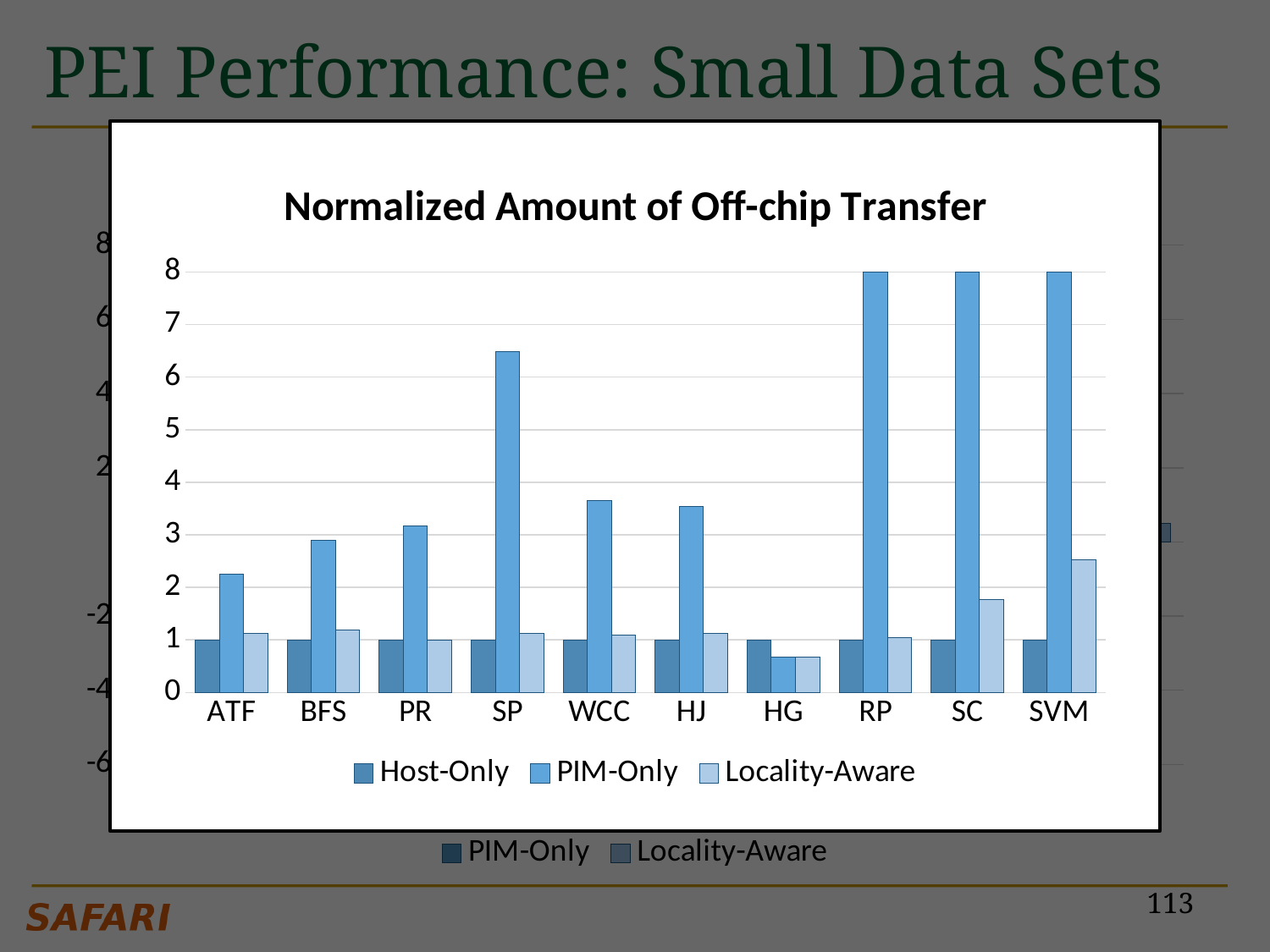
In the chart titled "Normalized Amount of Off-chip Transfer", what are the three series listed in the legend? Host-Only, PIM-Only, Locality-Aware In the chart titled "Normalized Amount of Off-chip Transfer", is the PIM-Only value for SP greater or less than 6? greater In the chart titled "Normalized Amount of Off-chip Transfer", which category has the highest Locality-Aware value? SVM In the chart titled "Normalized Amount of Off-chip Transfer", is the PIM-Only value for RP greater or less than 7? greater In the chart titled "Normalized Amount of Off-chip Transfer", which is larger: the Locality-Aware value for SVM or for SC? SVM In the chart titled "Normalized Amount of Off-chip Transfer", is the Locality-Aware value for HG greater or less than 1? less In the chart titled "Normalized Amount of Off-chip Transfer", how many series does the legend list? 3 In the chart titled "Normalized Amount of Off-chip Transfer", which category has the lowest PIM-Only value? HG In the chart titled "Normalized Amount of Off-chip Transfer", which category has the lowest Locality-Aware value? HG In the chart titled "Normalized Amount of Off-chip Transfer", how many categories are shown on the x axis? 10 In the chart titled "Normalized Amount of Off-chip Transfer", what kind of chart is shown? bar chart